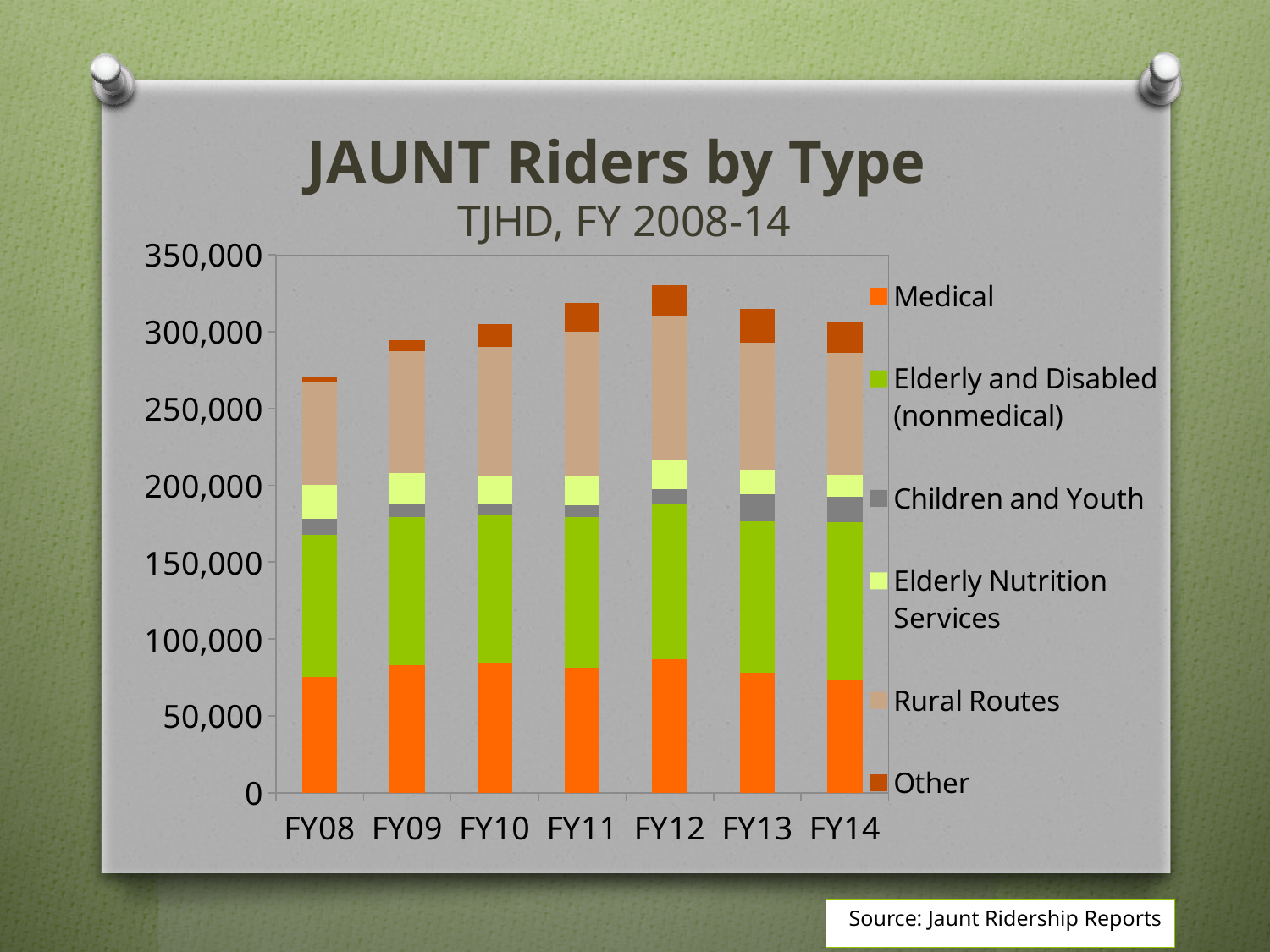
Do the total bar heights rise or fall from FY08 to FY12? rise Is the total bar height for FY12 greater or less than 300,000? greater Is the Medical segment for FY08 greater or less than 100,000? less What is the title of the chart? JAUNT Riders by Type Is the total bar height for FY09 greater or less than 300,000? less Which fiscal year has the tallest total bar? FY12 What kind of chart is shown on the slide? Stacked bar chart How many fiscal years are shown on the x axis of the chart? 7 Which is larger, the total bar for FY12 or the total bar for FY08? FY12 Which fiscal year has the shortest total bar? FY08 How many series does the chart's legend list? 6